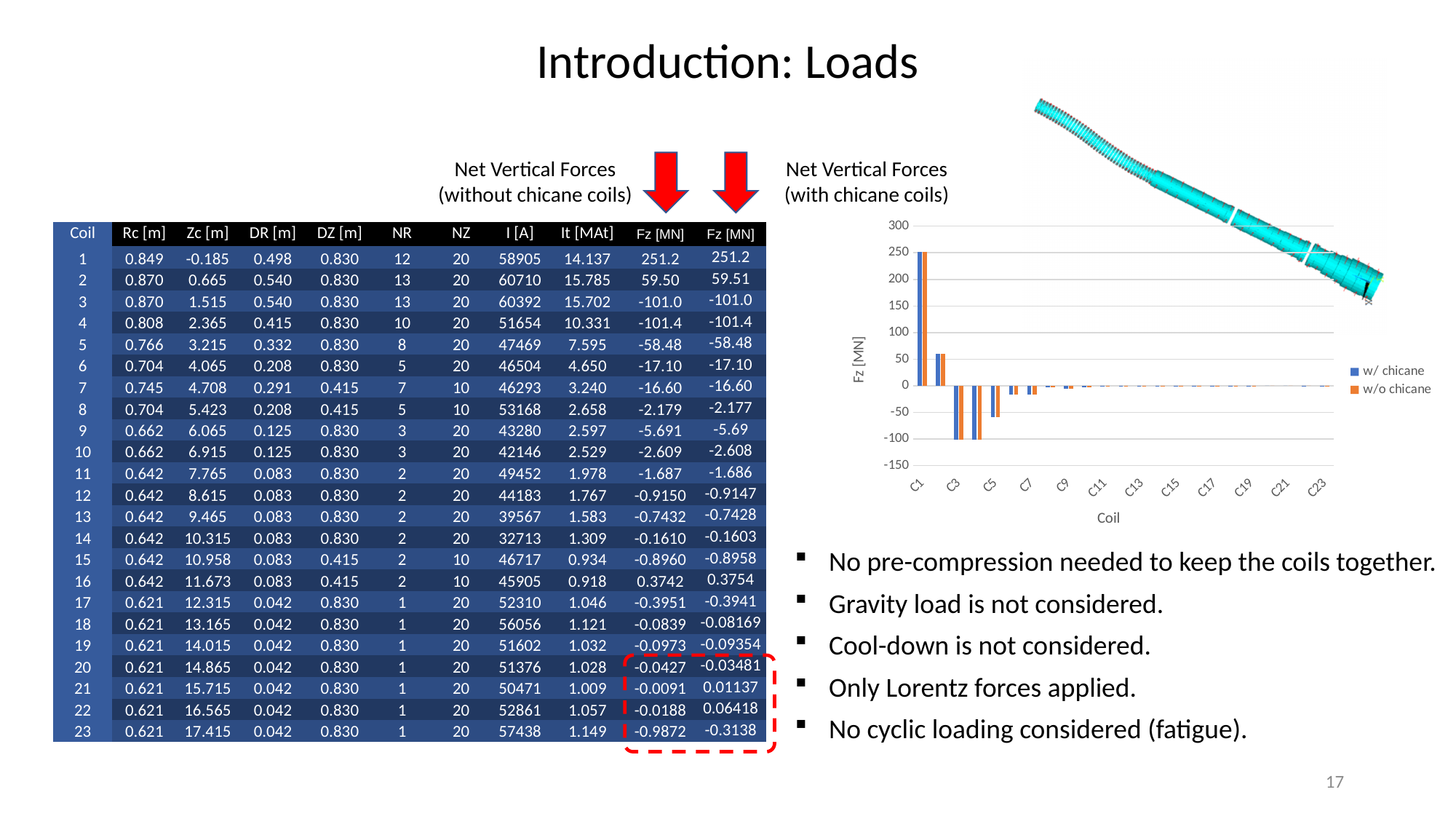
What is the highest tick value shown on the chart's vertical axis? 300 Is the w/o chicane value for C2 greater or less than 100? less What is the title of the chart's vertical axis? Fz [MN] Which is larger in the chart, the w/ chicane value for C1 or for C2? C1 What kind of chart is shown on the slide? bar chart Which coil has the highest Fz value in the chart? C1 How many series does the chart legend list? 2 What are the two series named in the chart legend? w/ chicane and w/o chicane Is the w/ chicane value for C3 greater or less than -50? less Is the w/ chicane value for C5 greater or less than 0? less